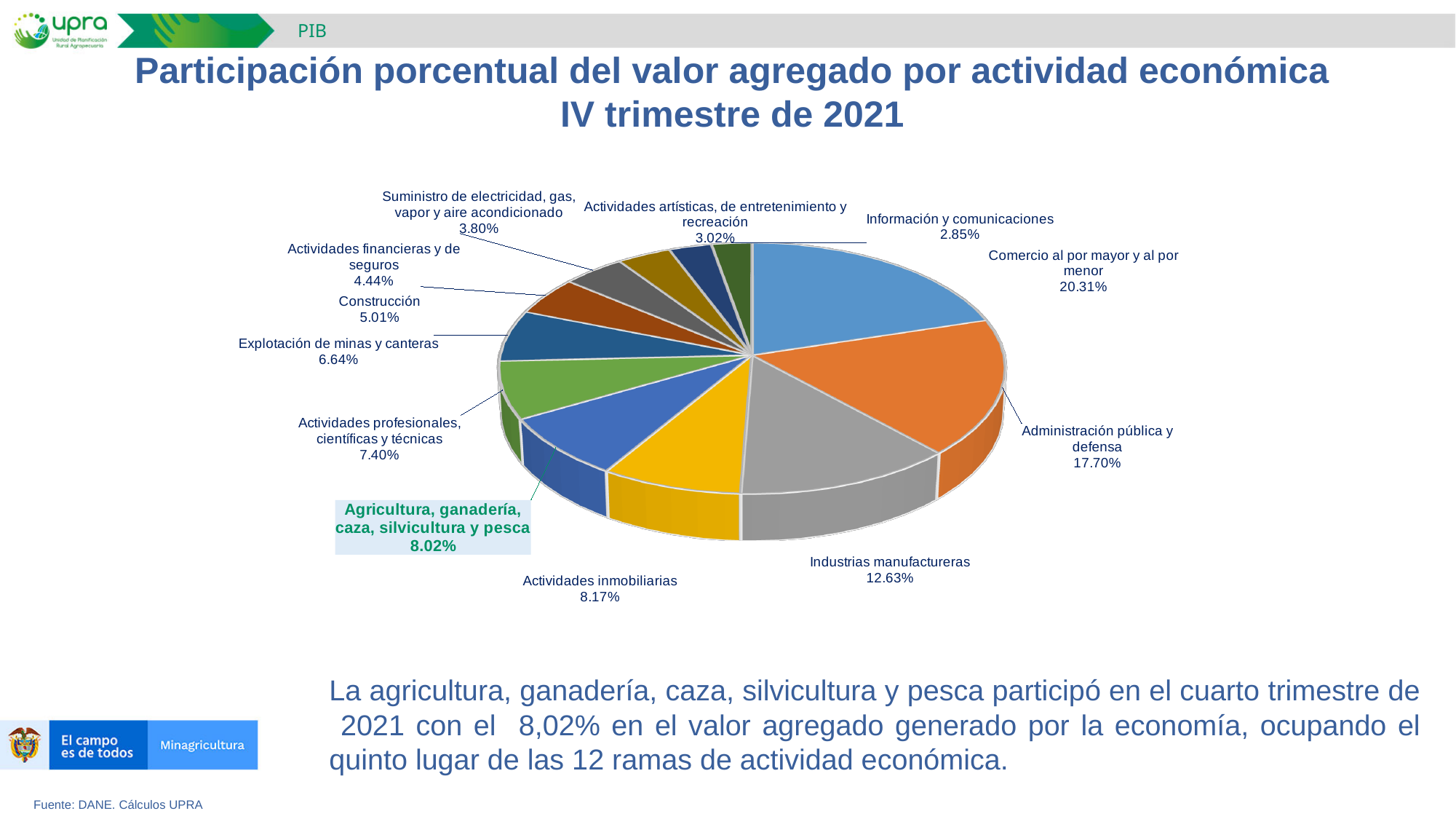
What is the value shown for Industrias manufactureras? 12.63% What type of chart is shown on the slide? Pie chart Which economic activity has the largest share in the pie chart? Comercio al por mayor y al por menor What percentage does Explotación de minas y canteras represent? 6.64% Which has a larger share, Actividades inmobiliarias or Agricultura, ganadería, caza, silvicultura y pesca? Actividades inmobiliarias What is the difference in percentage points between Industrias manufactureras and Agricultura, ganadería, caza, silvicultura y pesca? 4.61 What share of value added does Comercio al por mayor y al por menor have in the pie chart? 20.31% What is the difference in percentage points between Comercio al por mayor y al por menor and Administración pública y defensa? 2.61 How many economic activities (slices) are shown in the pie chart? 12 Which economic activity has the smallest share in the pie chart? Información y comunicaciones What is the title of the chart on the slide? Participación porcentual del valor agregado por actividad económica IV trimestre de 2021 What percentage is shown for Agricultura, ganadería, caza, silvicultura y pesca? 8.02%